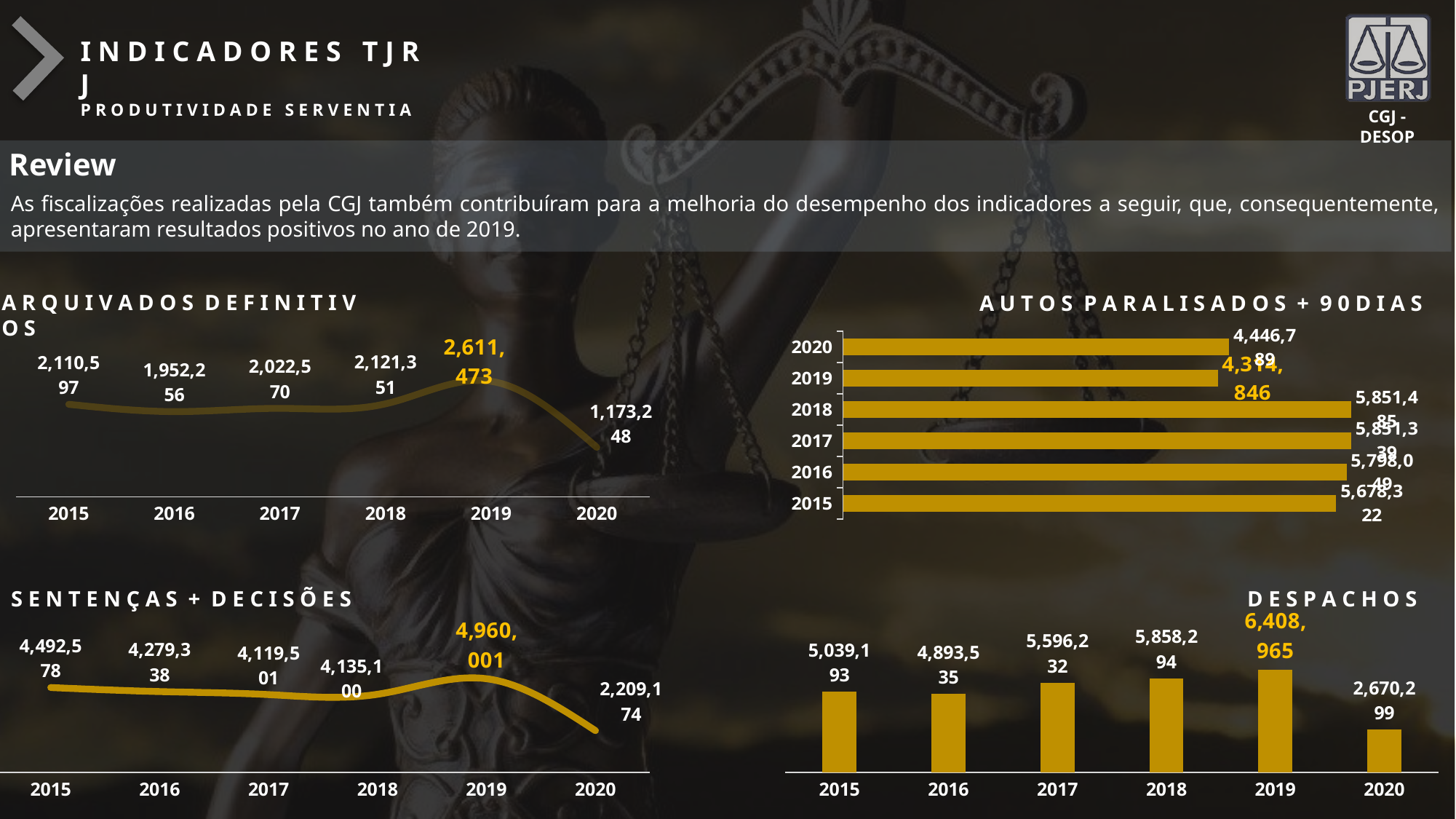
In the AUTOS PARALISADOS + 90 DIAS chart, which year has the shortest bar? 2019 In the SENTENÇAS + DECISÕES chart, what is the value for 2020? 2,209,174 What kind of chart is the AUTOS PARALISADOS + 90 DIAS chart? bar chart In the ARQUIVADOS DEFINITIVOS chart, what is the value for 2019? 2,611,473 What kind of chart is the SENTENÇAS + DECISÕES chart? line chart How many years are shown in the DESPACHOS chart? 6 In the DESPACHOS chart, which is larger, the value for 2017 or the value for 2016? 2017 In the AUTOS PARALISADOS + 90 DIAS chart, what is the value for 2015? 5,678,322 In the DESPACHOS chart, what is the value for 2019? 6,408,965 In the ARQUIVADOS DEFINITIVOS chart, which year has the lowest value? 2020 In the ARQUIVADOS DEFINITIVOS chart, which year has the highest value? 2019 In the SENTENÇAS + DECISÕES chart, what is the difference between the 2019 and 2020 values? 2,750,827